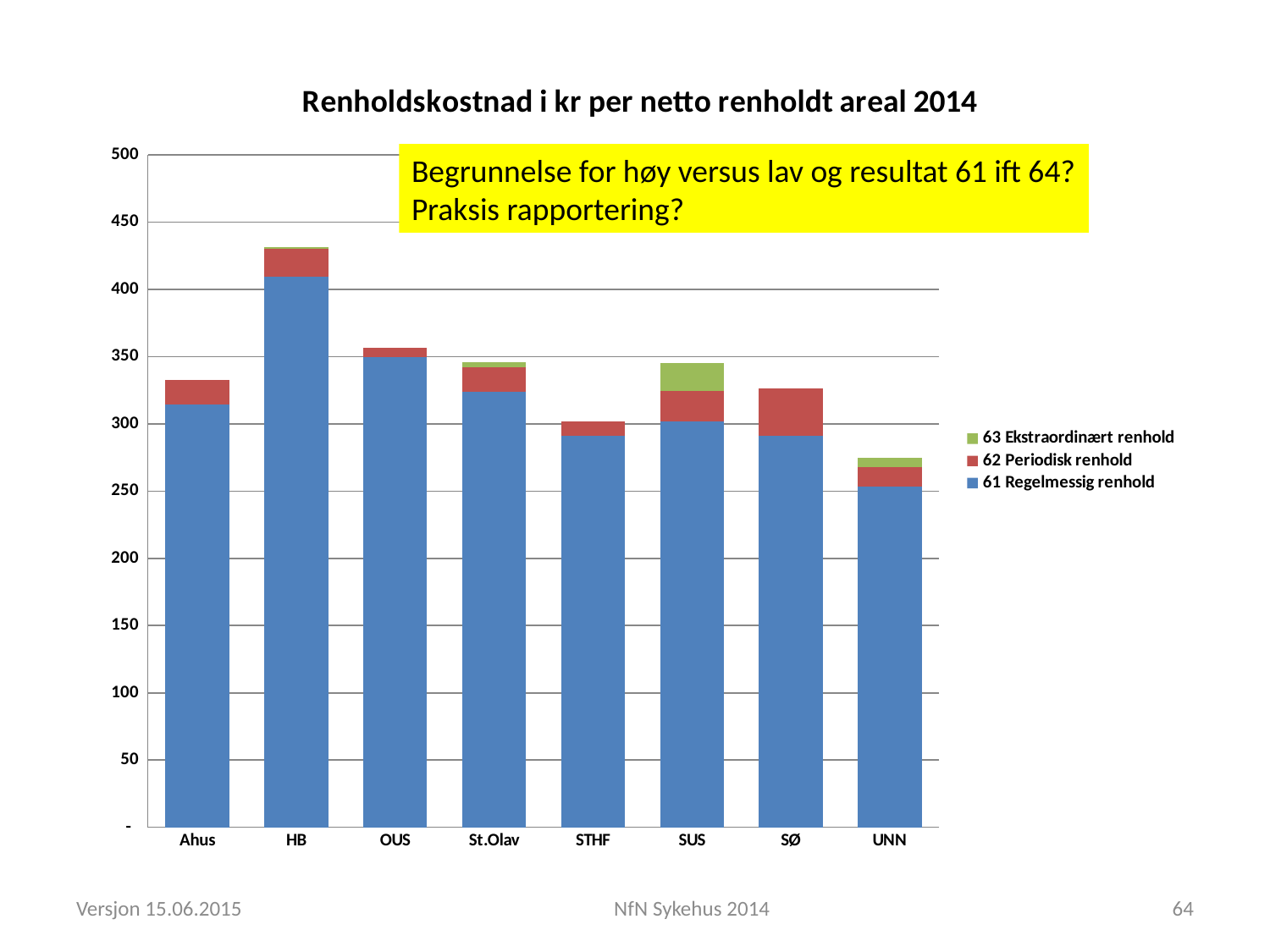
Which hospital has the lowest total bar in the chart? UNN Is the value of 61 Regelmessig renhold for Ahus greater or less than 300? greater Which has the larger total bar, SØ or UNN? SØ How many hospitals (categories) are shown on the x axis of the chart? 8 What is the title of the chart? Renholdskostnad i kr per netto renholdt areal 2014 Which hospital has the highest total bar in the chart? HB How many series does the legend of the chart list? 3 Which hospital has the largest 63 Ekstraordinært renhold segment? SUS Which legend entry is shown in blue? 61 Regelmessig renhold What kind of chart is shown on the slide? Stacked bar chart Is the total value for HB greater or less than 400? greater Is the total value for UNN greater or less than 300? less